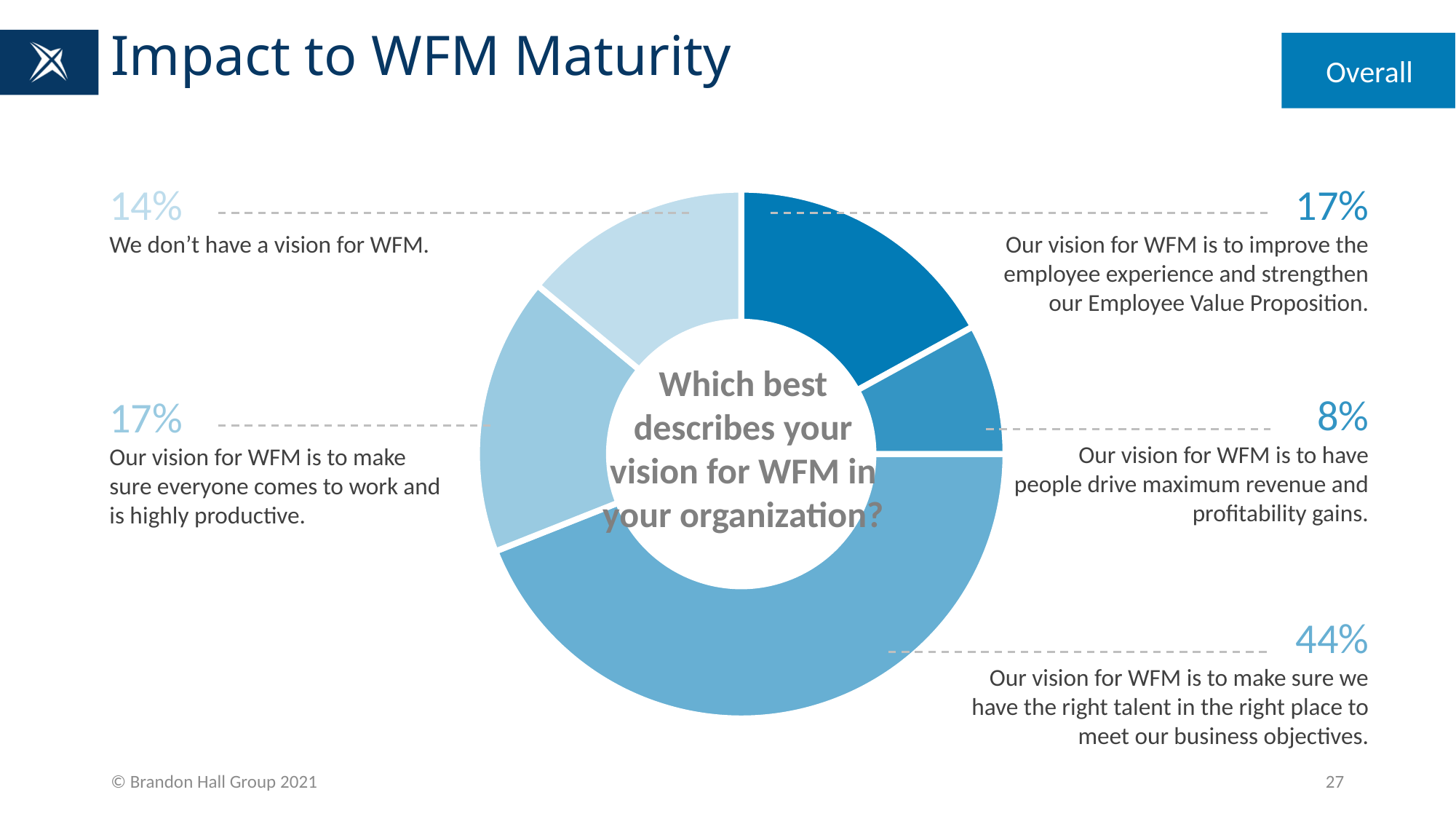
What percentage of respondents said their vision for WFM is to make sure they have the right talent in the right place to meet business objectives? 44% Which response has the smallest share of the donut chart? Our vision for WFM is to have people drive maximum revenue and profitability gains. What type of chart is shown on the slide? Donut (pie) chart What question is written in the center of the donut chart? Which best describes your vision for WFM in your organization? What percentage of respondents said their vision for WFM is to have people drive maximum revenue and profitability gains? 8% What percentage of respondents said they don't have a vision for WFM? 14% What percentage of respondents said their vision for WFM is to improve the employee experience and strengthen the Employee Value Proposition? 17% What is the title of the slide containing the chart? Impact to WFM Maturity What is the difference in percentage points between the largest slice (44%) and the slice for 'We don't have a vision for WFM' (14%)? 30 percentage points How many response categories are shown in the donut chart? 5 Which is larger: the share for 'We don't have a vision for WFM' or the share for 'Our vision for WFM is to have people drive maximum revenue and profitability gains'? We don't have a vision for WFM (14%) Which response has the largest share of the donut chart? Our vision for WFM is to make sure we have the right talent in the right place to meet our business objectives.